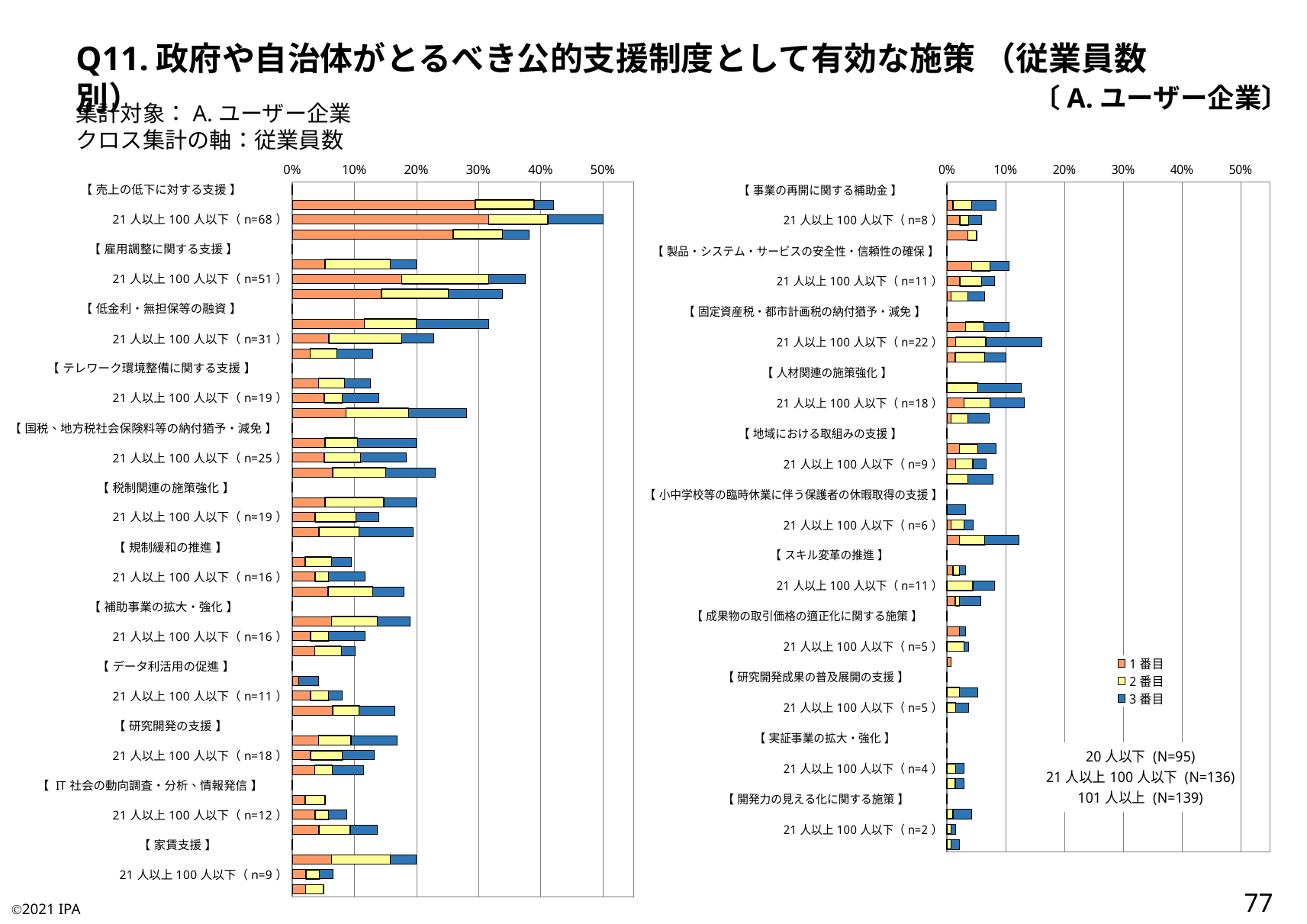
How many series does the legend on the right chart list? 3 In the left chart, is the total bar for 21人以上100人以下 (n=68) under 売上の低下に対する支援 greater or less than 40%? greater In the left chart, which measure group contains the longest stacked bar? 売上の低下に対する支援 In the left chart, is the total bar for 21人以上100人以下 (n=9) under 家賃支援 greater or less than 10%? less How many measure groups (bracketed headings) are shown in the right chart? 11 In the right chart, is the total bar for 21人以上100人以下 (n=2) under 開発力の見える化に関する施策 greater or less than 10%? less In the left chart, which is larger: the total bar for 21人以上100人以下 (n=68) under 売上の低下に対する支援 or the total bar for 21人以上100人以下 (n=11) under データ利活用の促進? 売上の低下に対する支援 (n=68) How many measure groups (bracketed headings) are shown in the left chart? 12 What are the three legend entries shown on the right chart? 1番目, 2番目, 3番目 What is the highest value shown on the x axis of the left chart? 50% What kind of chart is the left chart on the slide? Stacked horizontal bar chart